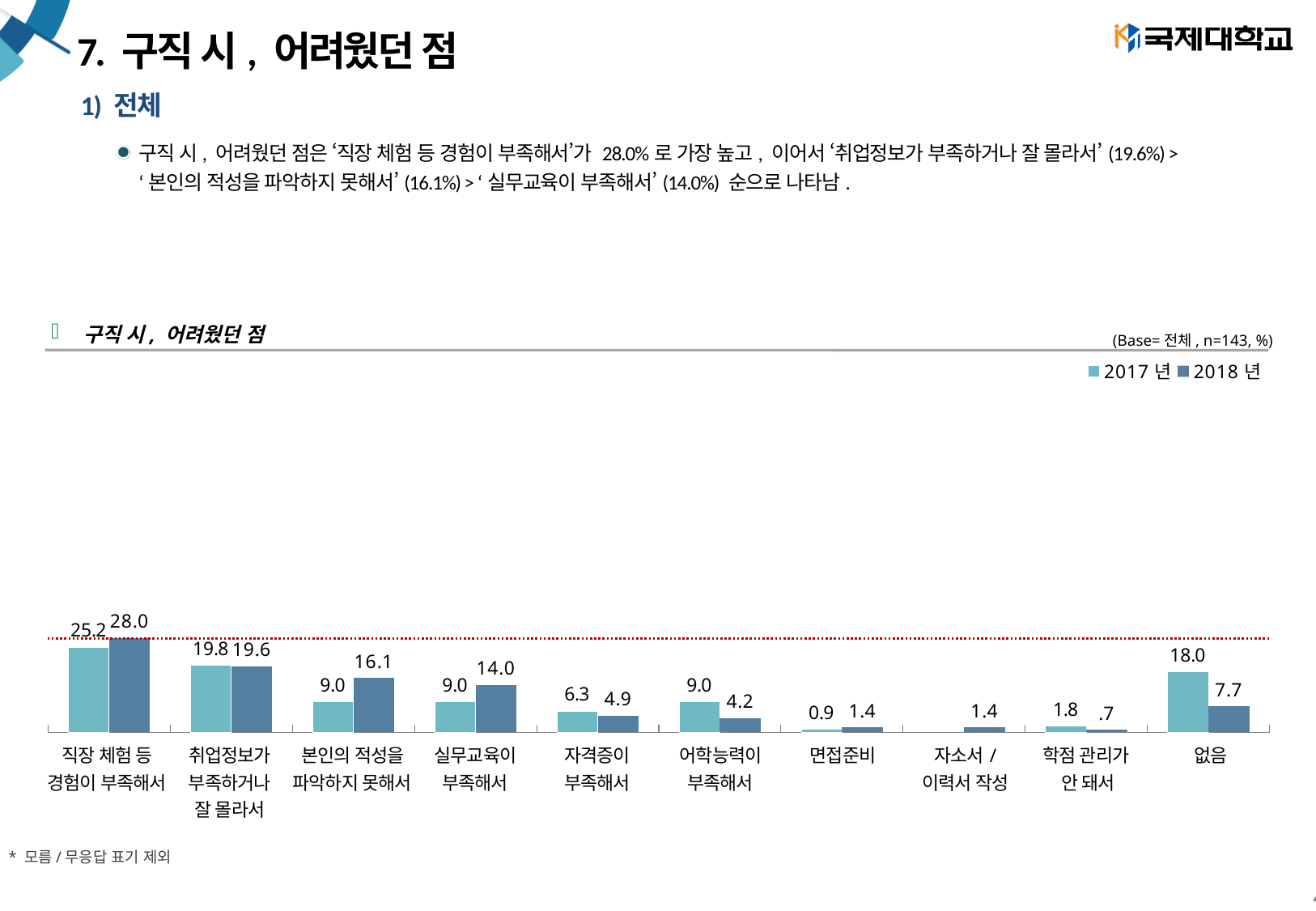
Which is larger for '어학능력이 부족해서', the 2017년 value or the 2018년 value? 2017년 What type of chart is shown on the slide? bar chart What is the difference between the 2018년 and 2017년 values for '실무교육이 부족해서'? 5.0 What is the 2018년 value for '직장 체험 등 경험이 부족해서'? 28.0 What is the 2017년 value for '없음'? 18.0 How many series does the legend list? 2 How many categories are shown on the x axis of the chart? 10 What is the 2018년 value for '본인의 적성을 파악하지 못해서'? 16.1 What are the two series names shown in the legend? 2017년, 2018년 Which category has the highest 2018년 value? 직장 체험 등 경험이 부족해서 What is the difference between the 2017년 and 2018년 values for '없음'? 10.3 Which category has the lowest 2018년 value? 학점 관리가 안 돼서